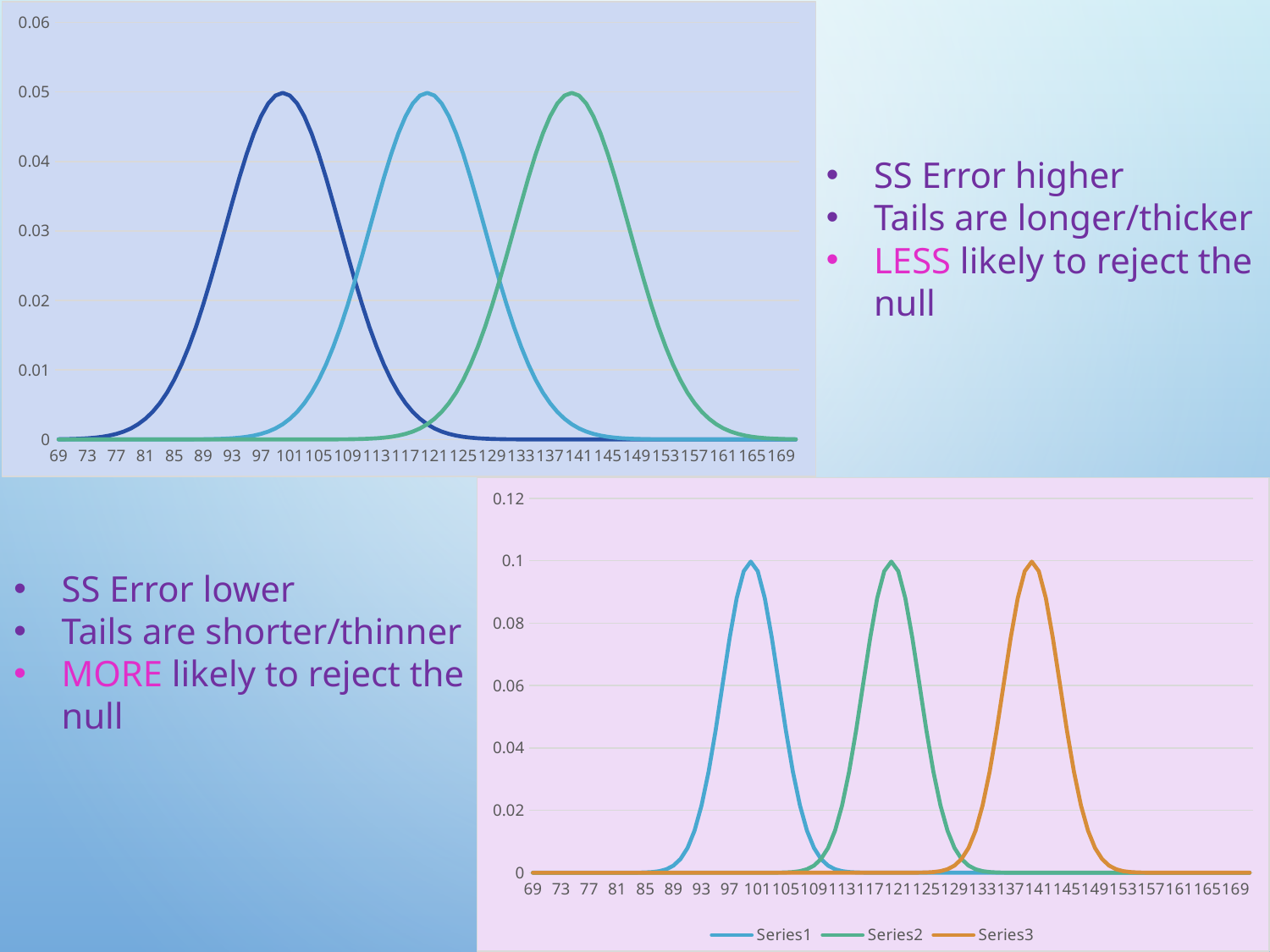
What kind of chart is the top-left chart? line chart In the top-left chart, is the peak value of the rightmost curve greater or less than 0.06? less In the bottom-right chart, which series has its peak furthest to the right along the x axis? Series3 How many series does the legend of the bottom-right chart list? 3 In the top-left chart, is the peak value of the leftmost curve greater or less than 0.04? greater In the bottom-right chart, is the peak value of Series1 greater or less than 0.08? greater In the bottom-right chart, does Series1 rise or fall between x = 101 and x = 113? fall What are the legend entries of the bottom-right chart? Series1, Series2, Series3 What kind of chart is the bottom-right chart? line chart How many curves are plotted on the top-left chart? 3 What colour is the Series3 line in the bottom-right chart? orange